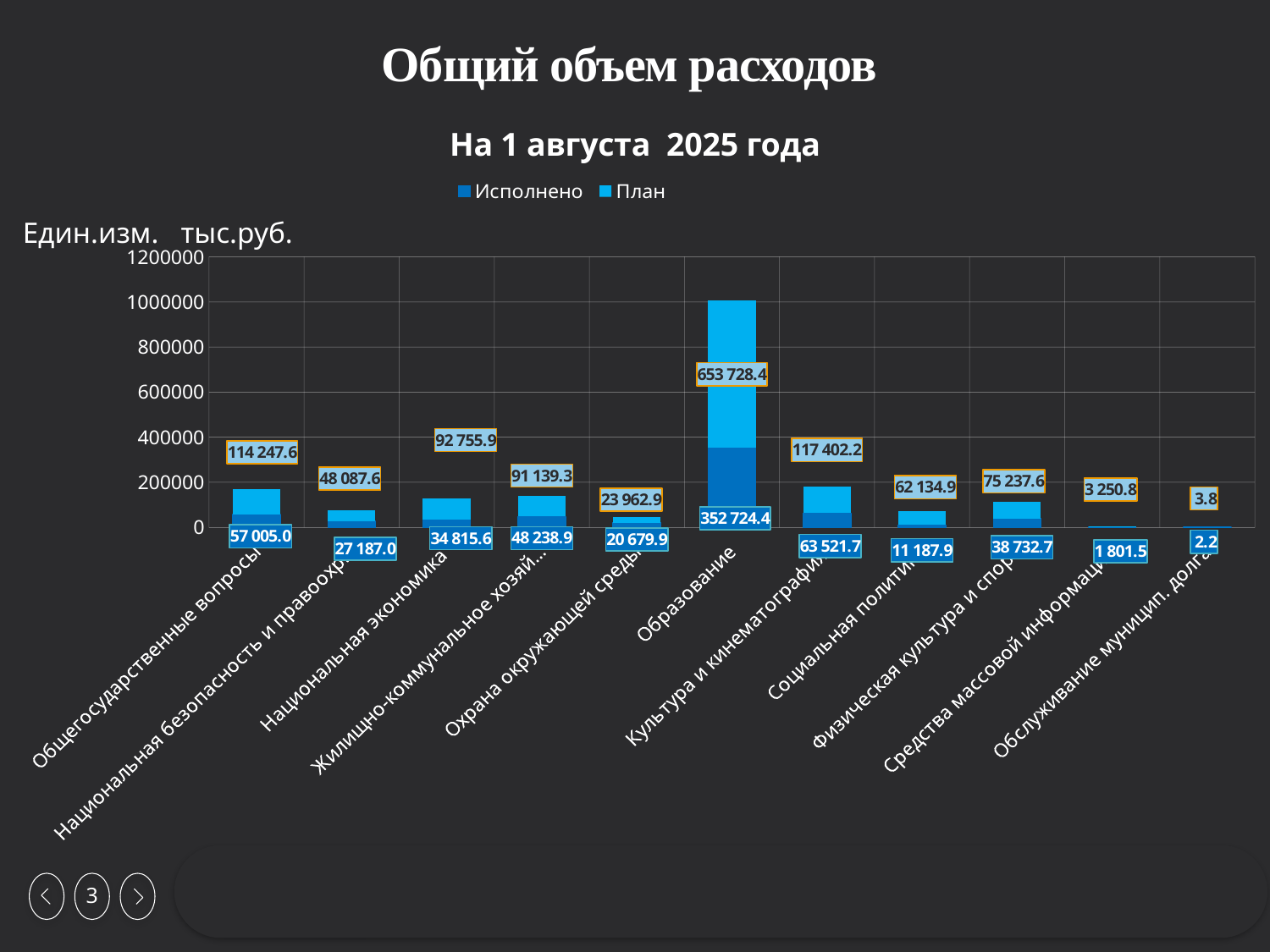
Which category has the highest Исполнено value? Образование What is the Исполнено value for Национальная экономика? 34 815.6 What unit of measurement is stated for the chart? тыс.руб. How many categories are shown on the x axis? 11 What is the total of the stacked bar for Образование (Исполнено plus План)? 1 006 452.8 What is the План value for Образование? 653 728.4 What kind of chart is shown on the slide? Stacked bar chart What is the Исполнено value for Охрана окружающей среды? 20 679.9 Which category has the lowest План value? Обслуживание муницип. долга What is the difference between the План and Исполнено values for Общегосударственные вопросы? 57 242.6 Which has the larger Исполнено value: Общегосударственные вопросы or Национальная экономика? Общегосударственные вопросы How many series does the legend list? 2